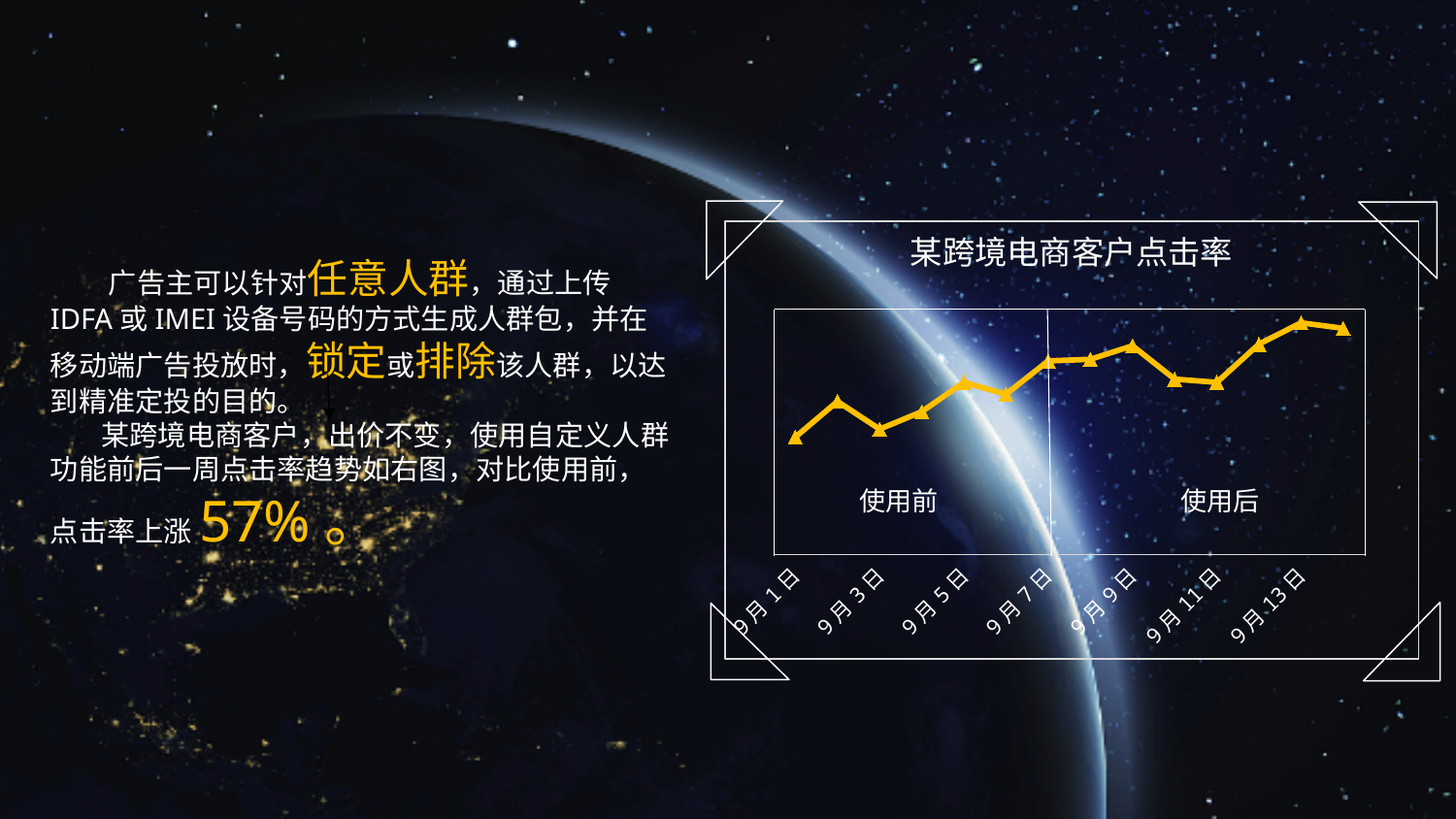
What is the first date label on the x axis? 9月1日 Which is higher, the value at 9月3日 or the value at 9月7日? 9月7日 What kind of chart is shown on the slide? line chart Does the click-through rate generally rise or fall from 9月1日 to 9月13日? rise How many lines are plotted in the chart? 1 What is the last date label on the x axis? 9月13日 Which is higher, the value at 9月1日 or the value at 9月13日? 9月13日 What is the title of the chart? 某跨境电商客户点击率 How many date labels are shown on the x axis of the chart? 7 Which is higher, the value at 9月5日 or the value at 9月9日? 9月9日 How many data points are plotted on the line? 14